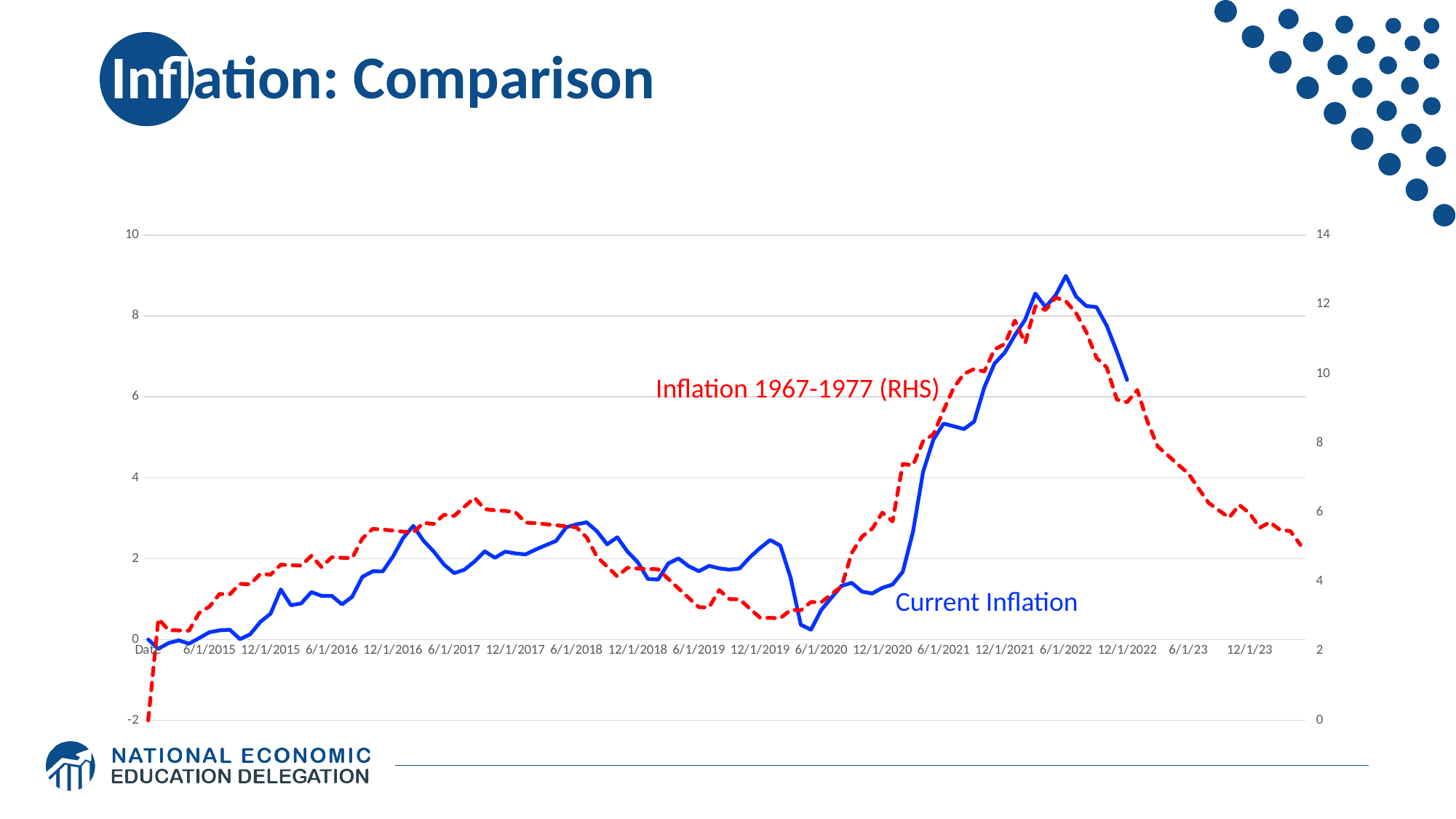
What kind of chart is shown on the slide? line chart Is the peak value of Current Inflation (left axis) greater or less than 8? greater Is Current Inflation higher at 6/1/2022 or at 6/1/2020? 6/1/2022 Does Inflation 1967-1977 rise or fall between 6/1/2022 and 12/1/23? fall What is the title of the slide? Inflation: Comparison Does Current Inflation rise or fall between 6/1/2021 and 6/1/2022? rise How many data series are plotted on the chart? 2 Which series is drawn as a red dashed line? Inflation 1967-1977 (RHS) Around which date does the Current Inflation series reach its highest value? 6/1/2022 Is the value of Current Inflation at 6/1/2020 (left axis) greater or less than 2? less Is the peak value of Inflation 1967-1977 (right axis) greater or less than 10? greater